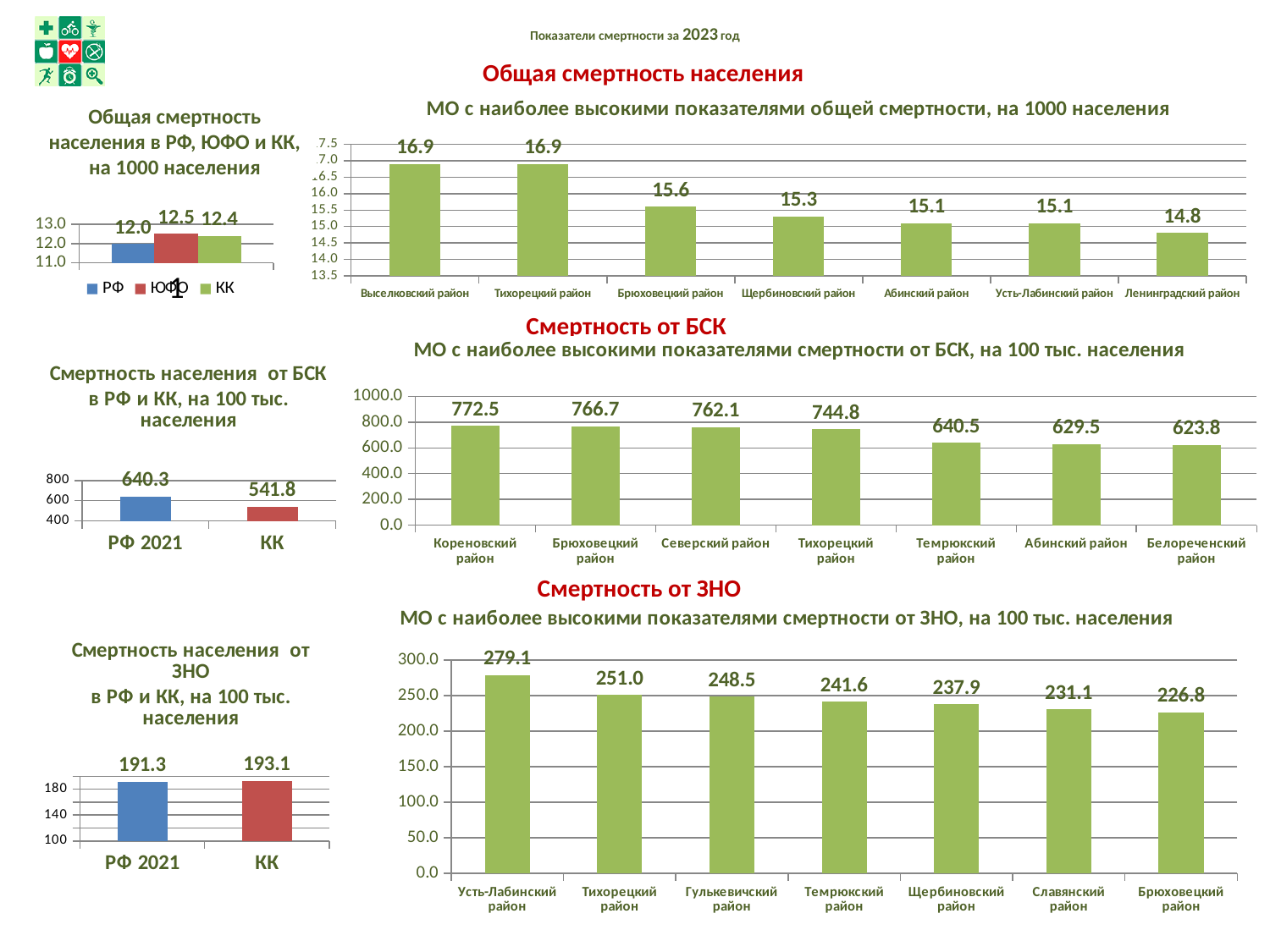
In the chart 'Общая смертность населения в РФ, ЮФО и КК, на 1000 населения', what is the value for ЮФО? 12.5 In the chart 'МО с наиболее высокими показателями смертности от БСК, на 100 тыс. населения', which district has the highest value? Кореновский район In the chart 'МО с наиболее высокими показателями смертности от ЗНО, на 100 тыс. населения', do the values rise or fall from left to right? fall In the chart 'Смертность населения от БСК в РФ и КК, на 100 тыс. населения', which is larger, РФ 2021 or КК? РФ 2021 In the chart 'Смертность населения от ЗНО в РФ и КК, на 100 тыс. населения', what is the value for КК? 193.1 In the chart 'МО с наиболее высокими показателями общей смертности, на 1000 населения', how many districts are shown? 7 In the chart 'МО с наиболее высокими показателями смертности от БСК, на 100 тыс. населения', what is the difference between Кореновский район and Белореченский район? 148.7 In the chart 'МО с наиболее высокими показателями общей смертности, на 1000 населения', which district has the lowest value? Ленинградский район What kind of chart is 'МО с наиболее высокими показателями смертности от ЗНО, на 100 тыс. населения'? bar chart In the chart 'Общая смертность населения в РФ, ЮФО и КК, на 1000 населения', how many series does the legend list? 3 In the chart 'МО с наиболее высокими показателями смертности от ЗНО, на 100 тыс. населения', what is the value for Гулькевичский район? 248.5 In the chart 'МО с наиболее высокими показателями общей смертности, на 1000 населения', what is the value for Брюховецкий район? 15.6